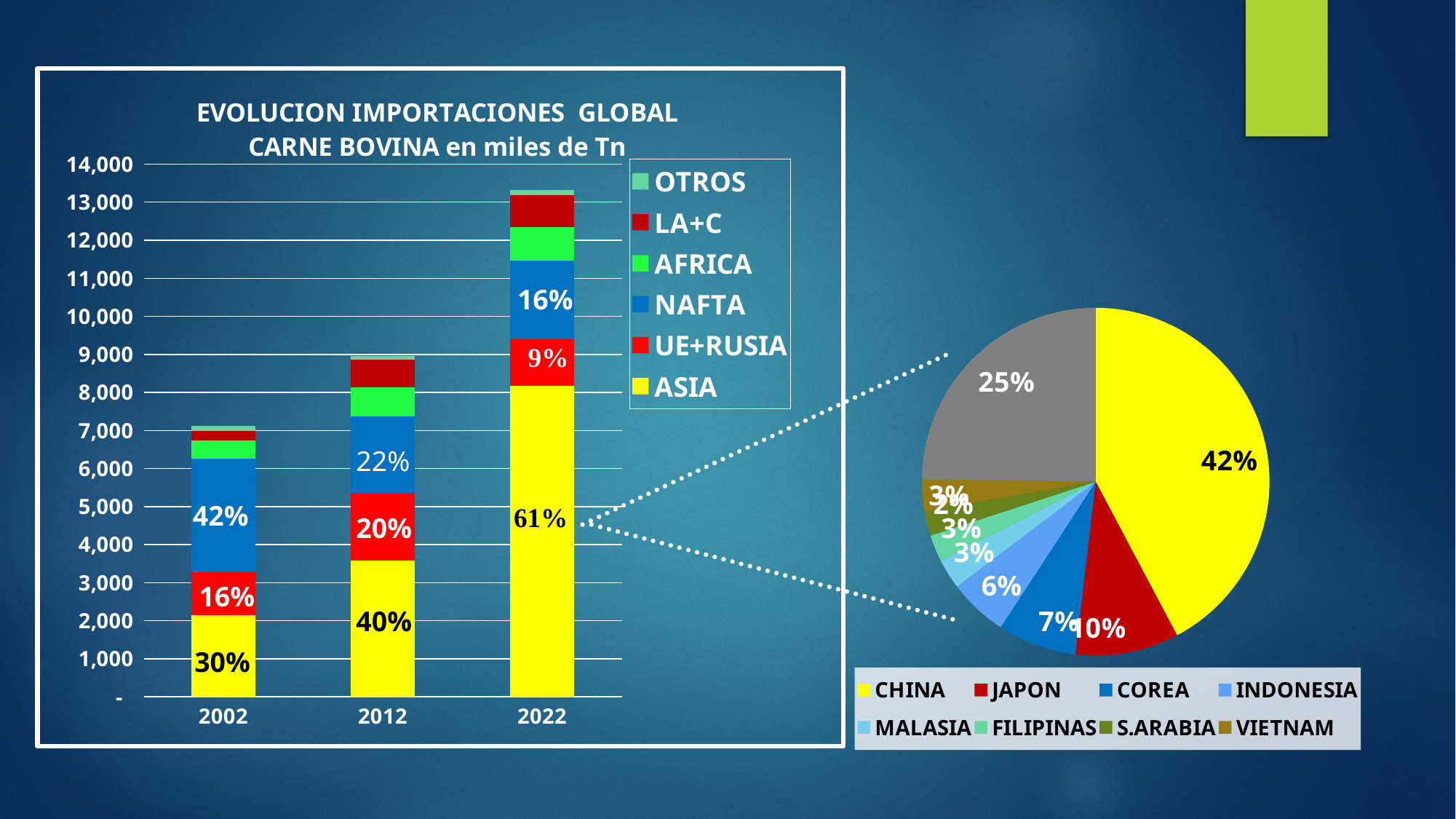
In the bar chart 'EVOLUCION IMPORTACIONES GLOBAL CARNE BOVINA en miles de Tn', what percentage label is shown for NAFTA in 2002? 42% In the bar chart 'EVOLUCION IMPORTACIONES GLOBAL CARNE BOVINA en miles de Tn', does the ASIA percentage rise or fall from 2002 to 2022? rise In the bar chart 'EVOLUCION IMPORTACIONES GLOBAL CARNE BOVINA en miles de Tn', what percentage label is shown for UE+RUSIA in 2012? 20% In the pie chart on the right, which legend entry has the largest slice? CHINA In the pie chart on the right, what share is shown for CHINA? 42% What kind of chart is the chart titled 'EVOLUCION IMPORTACIONES GLOBAL CARNE BOVINA en miles de Tn'? stacked bar chart In the bar chart 'EVOLUCION IMPORTACIONES GLOBAL CARNE BOVINA en miles de Tn', how many series does the legend list? 6 In the bar chart 'EVOLUCION IMPORTACIONES GLOBAL CARNE BOVINA en miles de Tn', how many years are shown on the x axis? 3 In the pie chart on the right, what is the difference between the JAPON share and the COREA share? 3% In the bar chart 'EVOLUCION IMPORTACIONES GLOBAL CARNE BOVINA en miles de Tn', what percentage label is shown for ASIA in 2022? 61% In the bar chart 'EVOLUCION IMPORTACIONES GLOBAL CARNE BOVINA en miles de Tn', is the total height of the 2022 bar greater or less than 12,000? greater In the bar chart 'EVOLUCION IMPORTACIONES GLOBAL CARNE BOVINA en miles de Tn', which year has the larger NAFTA percentage, 2002 or 2012? 2002